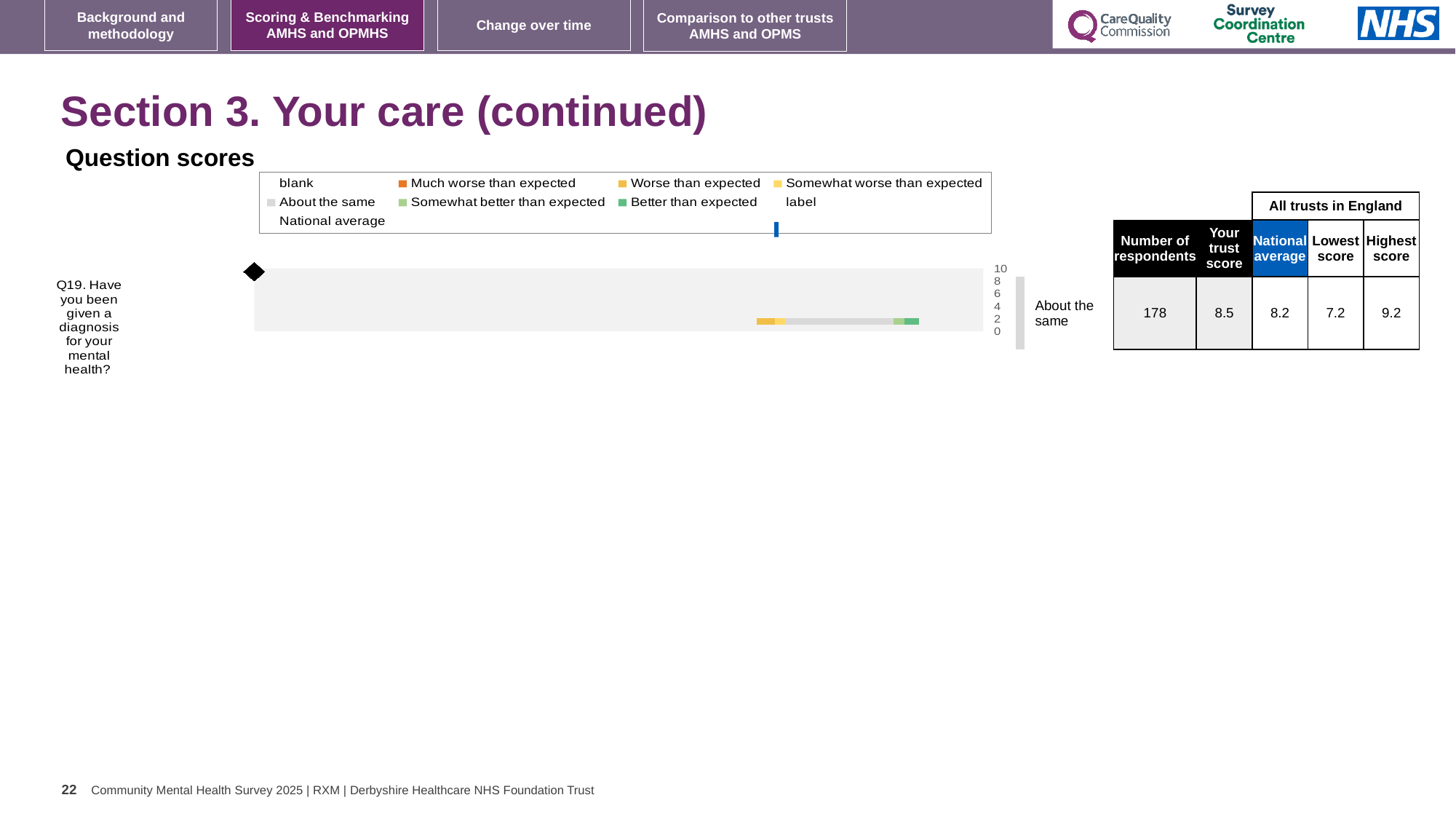
What colour does the legend use for 'Much worse than expected'? orange Which benchmark category is the trust's Q19 score placed in? About the same By how much does the trust's score for Q19 exceed the national average? 0.3 For Q19, which is larger: the trust's score or the national average? Your trust score How many questions are plotted in the Question scores chart? 1 How many respondents answered Q19? 178 What is the national average score for Q19? 8.2 What kind of chart is used to show the Q19 question score? bar chart What is the difference between the highest and lowest trust scores for Q19? 2.0 What is the 'Your trust score' for Q19 (Have you been given a diagnosis for your mental health?)? 8.5 What is the highest score among all trusts in England for Q19? 9.2 What is the lowest score among all trusts in England for Q19? 7.2